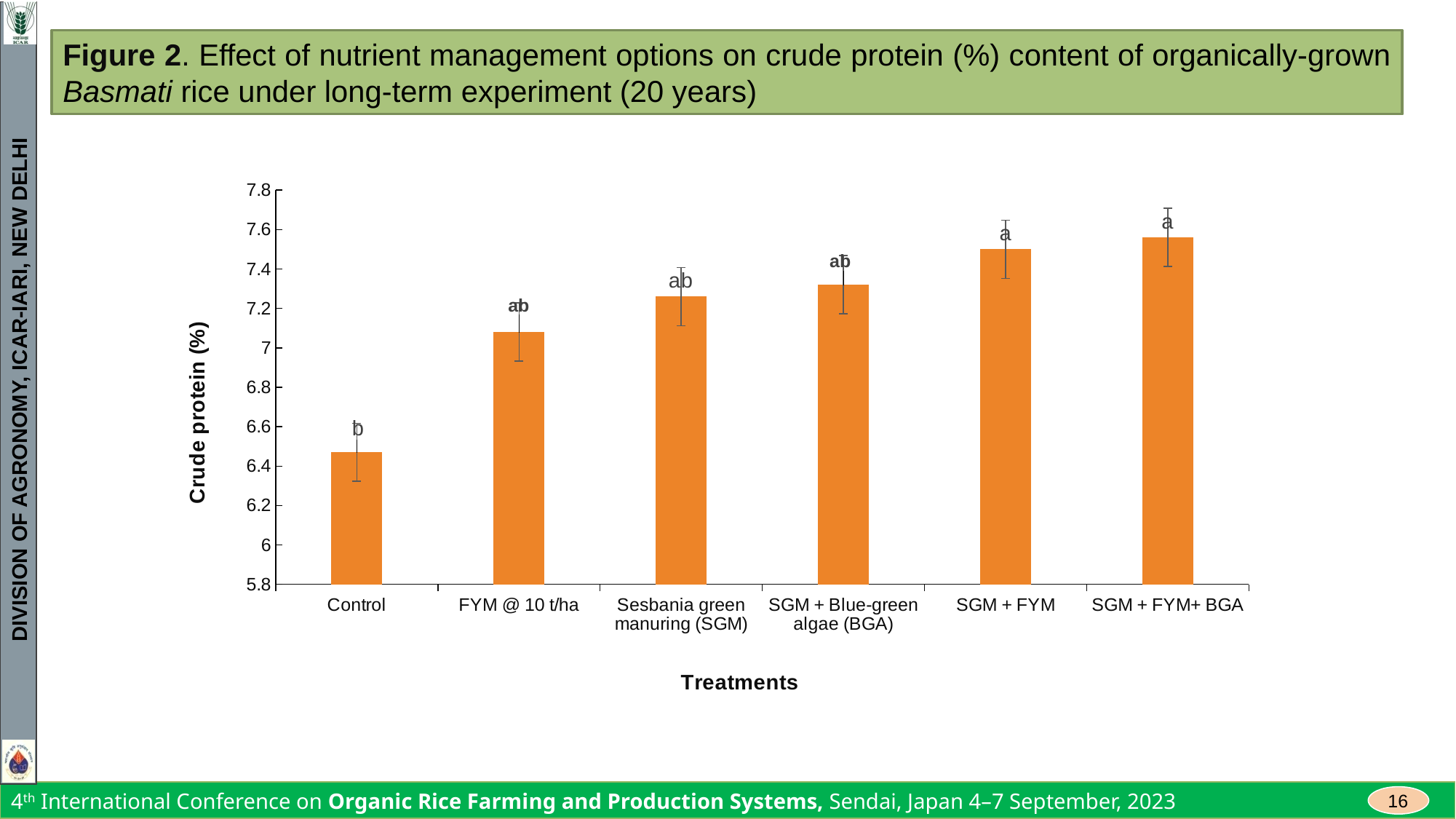
Which is larger, the value for Control or the value for FYM @ 10 t/ha? FYM @ 10 t/ha How many treatments are plotted on the x axis? 6 Is the value for Control greater or less than 6.6? less Is the value for SGM + Blue-green algae (BGA) greater or less than 7.2? greater What is the title of the y axis? Crude protein (%) Do the crude protein values rise or fall from Control to SGM + FYM+ BGA along the x axis? rise Which treatment has the lowest crude protein content? Control Is the value for FYM @ 10 t/ha greater or less than 7? greater What kind of chart is shown on the slide? bar chart What is the title of the x axis? Treatments